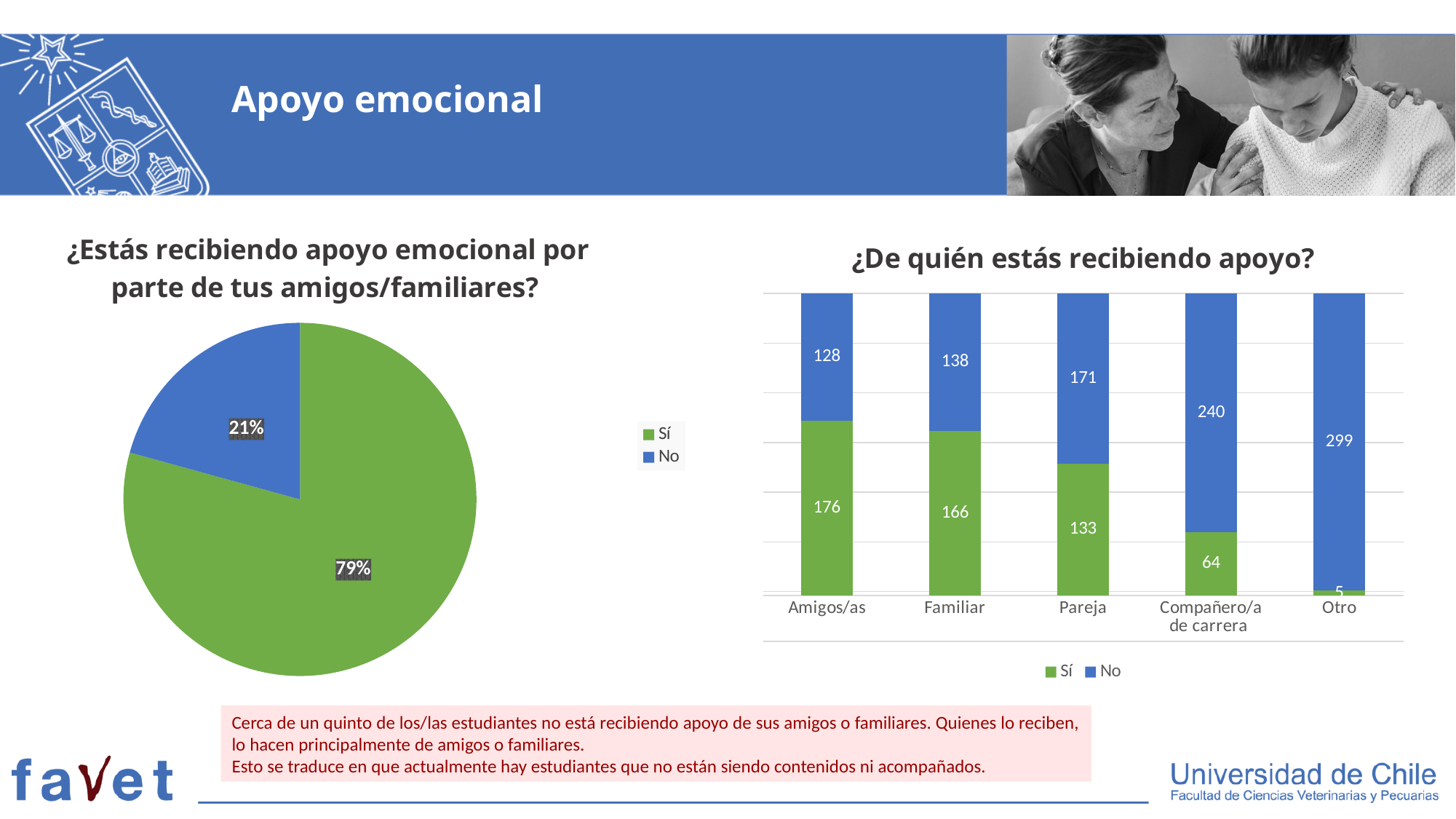
In the chart '¿De quién estás recibiendo apoyo?', which category has the lowest 'Sí' value? Otro In the chart '¿De quién estás recibiendo apoyo?', what is the total of the stacked bar for Familiar? 304 In the pie chart '¿Estás recibiendo apoyo emocional por parte de tus amigos/familiares?', what share of respondents answered 'No'? 21% In the chart '¿De quién estás recibiendo apoyo?', what is the difference between the 'No' value for Otro and the 'No' value for Amigos/as? 171 What kind of chart is '¿De quién estás recibiendo apoyo?'? Stacked bar chart In the chart '¿De quién estás recibiendo apoyo?', is the 'Sí' value for Pareja larger or the 'No' value for Pareja? No How many categories are shown on the x axis of the chart '¿De quién estás recibiendo apoyo?'? 5 In the pie chart '¿Estás recibiendo apoyo emocional por parte de tus amigos/familiares?', what share of respondents answered 'Sí'? 79% In the chart '¿De quién estás recibiendo apoyo?', what is the 'No' value for Compañero/a de carrera? 240 What kind of chart is the chart on the left of the slide? Pie chart In the chart '¿De quién estás recibiendo apoyo?', which category has the highest 'Sí' value? Amigos/as In the chart '¿De quién estás recibiendo apoyo?', what is the 'Sí' value for Amigos/as? 176